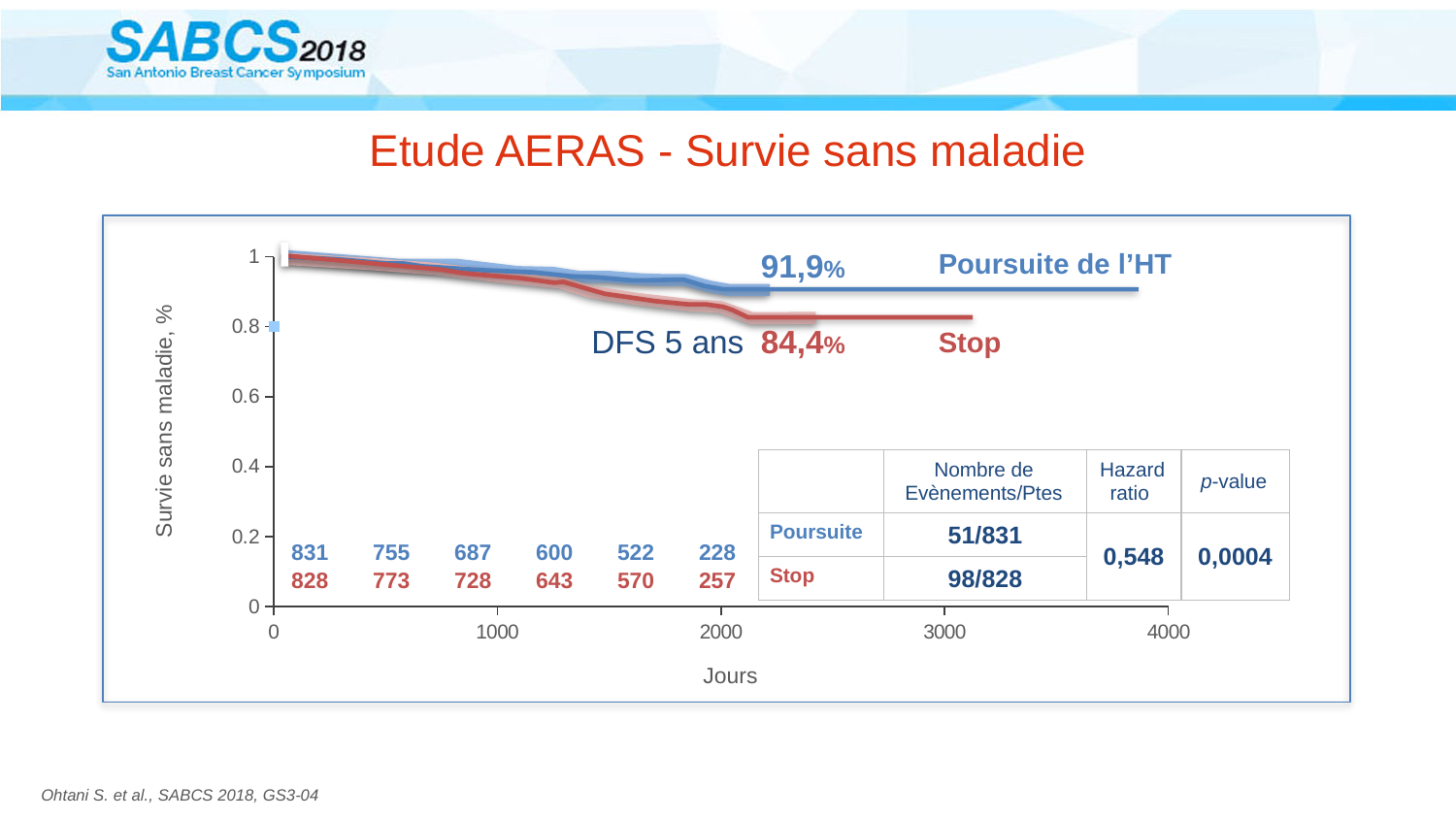
What is the number of events/patients for the 'Stop' group in the table? 98/828 How many groups (curves) are plotted on the chart? 2 What is the 5-year disease-free survival (DFS 5 ans) for the 'Stop' group? 84,4% What is the difference in 5-year DFS between the 'Poursuite de l'HT' group and the 'Stop' group? 7,5% How many patients were at risk in the 'Poursuite' group at day 0? 831 What kind of chart is shown on the slide? Line chart (survival curve) How many patients were at risk in the 'Stop' group at day 2000? 257 What is the hazard ratio shown in the table? 0,548 What is the label of the x axis? Jours Do the survival curves rise or fall as the number of days increases? Fall What is the 5-year disease-free survival (DFS 5 ans) for the 'Poursuite de l'HT' group? 91,9% Which group has the higher 5-year disease-free survival, 'Poursuite de l'HT' or 'Stop'? Poursuite de l'HT